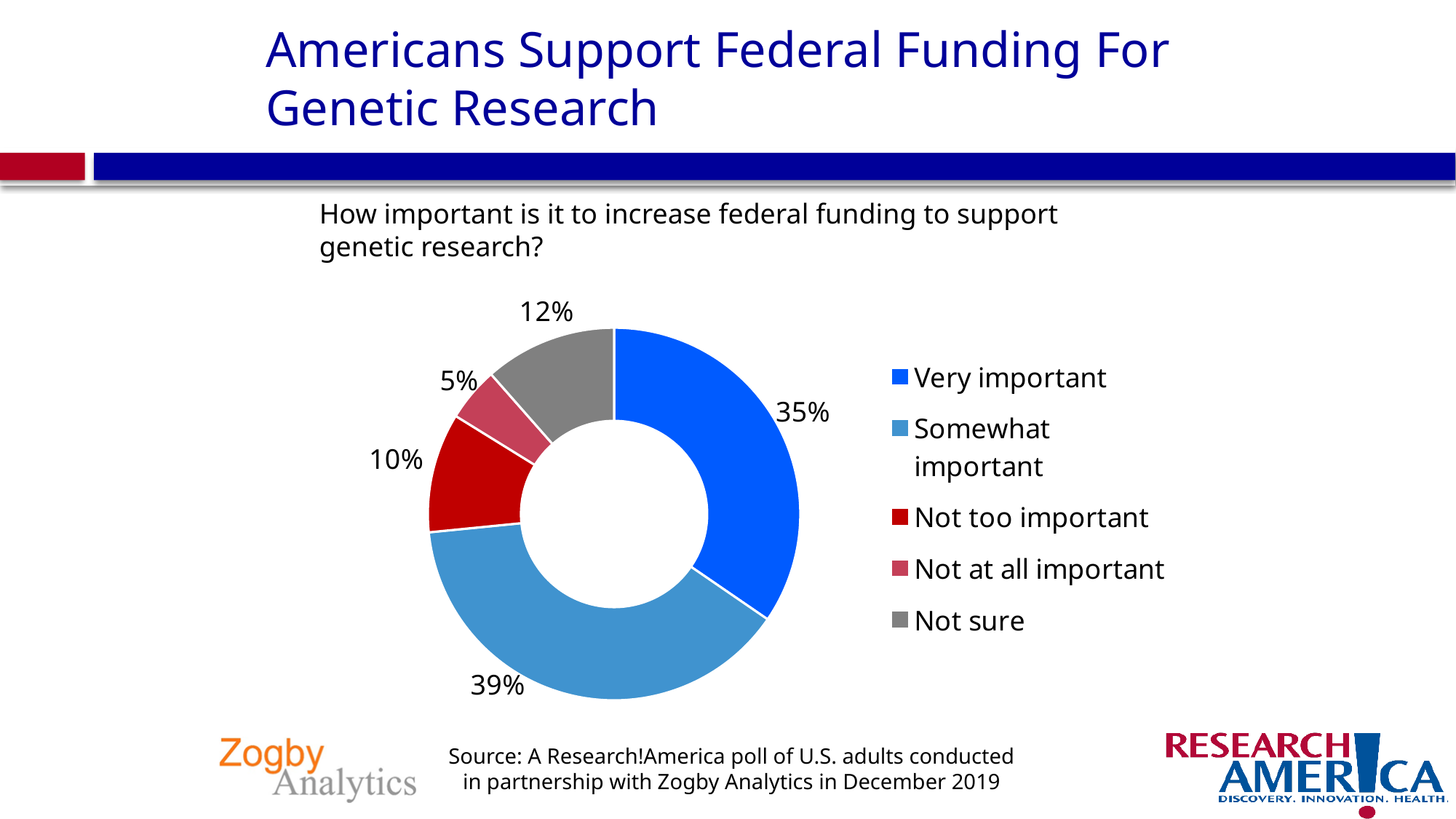
What is the difference in percentage points between 'Somewhat important' and 'Very important'? 4 Which response category has the smallest share of the pie? Not at all important What percentage of respondents were not sure? 12% What type of chart is shown on the slide? Pie chart (doughnut) What percentage of respondents said it is not at all important? 5% What percentage of respondents said it is somewhat important? 39% Which is larger: the share for 'Not sure' or the share for 'Not too important'? Not sure What colour represents 'Not sure' in the chart? Gray What percentage of respondents said increasing federal funding for genetic research is very important? 35% Which response category has the largest share of the pie? Somewhat important What percentage of respondents said it is not too important? 10% How many response categories are shown in the chart? 5